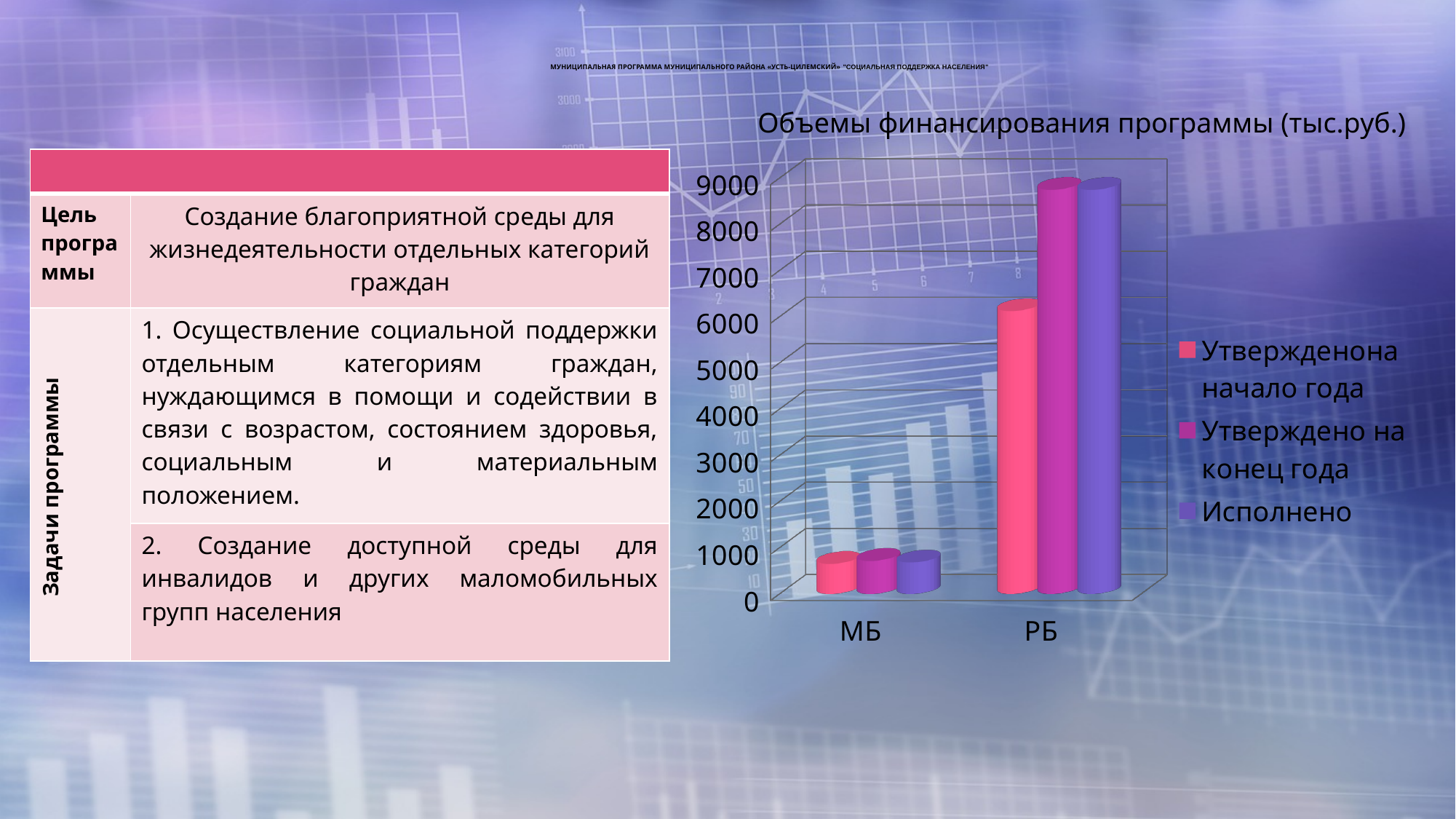
Is the value for РБ in the series 'Утвержденона начало года' greater or less than 5000? greater What kind of chart is shown on the slide? bar chart What is the title of the chart on the slide? Объемы финансирования программы (тыс.руб.) Which category has the higher values in the chart, МБ or РБ? РБ Is the value for МБ in the series 'Исполнено' greater or less than 1000? less Is the value for РБ in the series 'Утверждено на конец года' greater or less than 8000? greater Which category has the lowest values in the chart? МБ For РБ, which is larger: 'Утвержденона начало года' or 'Утверждено на конец года'? Утверждено на конец года How many series does the chart legend list? 3 Which legend entry is shown in purple in the chart? Исполнено How many categories are shown on the x axis of the chart? 2